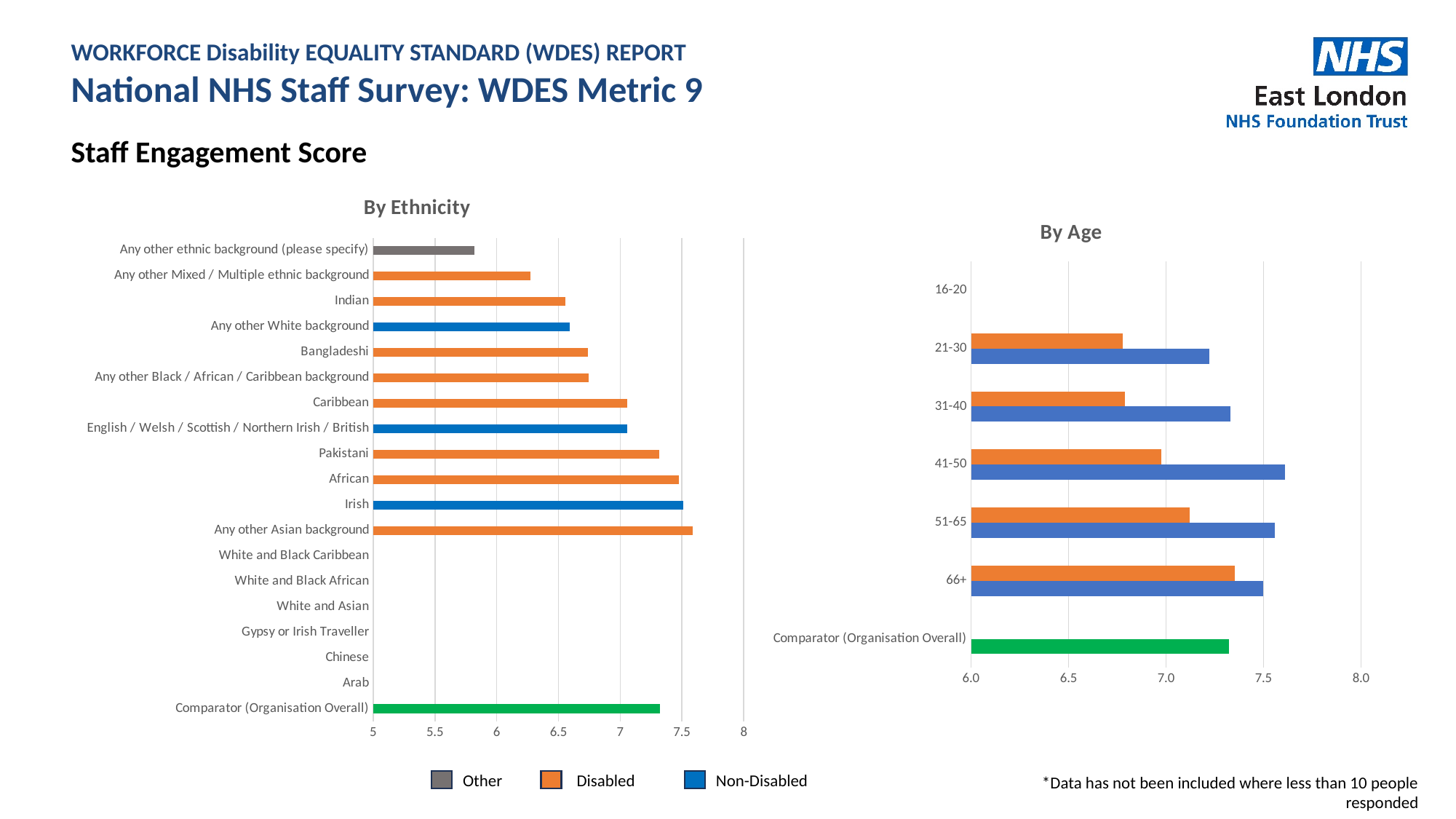
In the 'By Age' chart, which age group has the highest Disabled score? 66+ In the 'By Ethnicity' chart, is the value for Indian greater or less than 7? less In the 'By Age' chart, is the Non-Disabled value for 41-50 greater or less than 7.5? greater In the 'By Ethnicity' chart, which category has the lowest staff engagement score? Any other ethnic background (please specify) In the 'By Ethnicity' chart, which category has the highest staff engagement score? Any other Asian background How many age categories are labelled on the 'By Age' chart, including the Comparator? 7 What colour is the Comparator (Organisation Overall) bar in both charts? green In the 'By Ethnicity' chart, which is larger, the value for Pakistani or the value for Indian? Pakistani In the 'By Ethnicity' chart, is the value for Pakistani greater or less than 7? greater In the 'By Age' chart, for the 21-30 group, which is larger, the Disabled or the Non-Disabled value? Non-Disabled What kind of chart is the 'By Ethnicity' chart? bar chart How many series does the legend list? 3